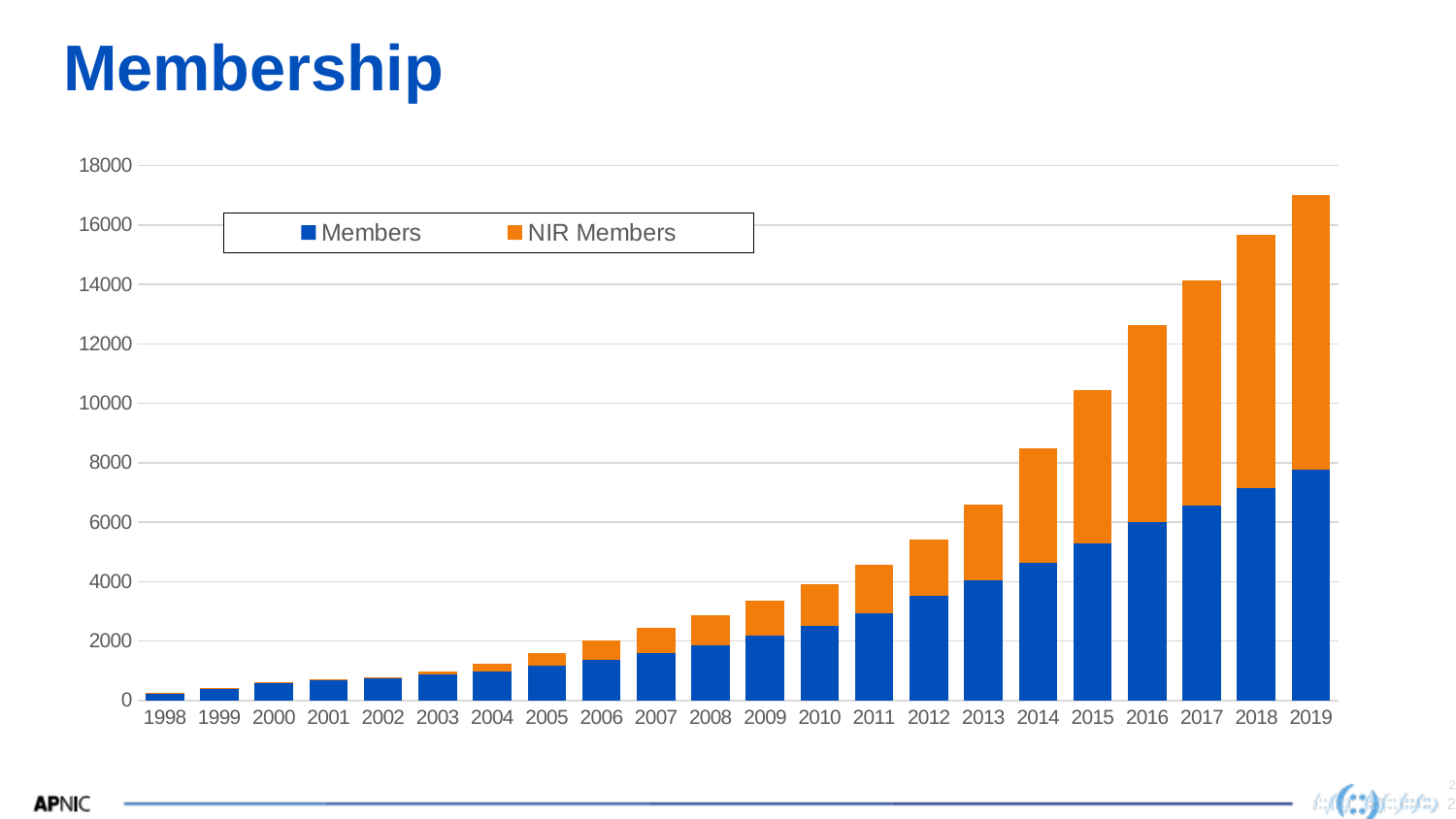
Is the total bar for 2016 greater or less than 12000? greater How many years are shown along the x axis? 22 Do the total membership bars rise or fall from 1998 to 2019? rise What kind of chart is shown on the slide? stacked bar chart Which year has the highest total membership bar? 2019 Is the total bar for 2015 greater or less than 10000? greater Which year has the lowest total membership bar? 1998 How many series does the legend list? 2 What are the two series named in the legend? Members and NIR Members Is the total bar for 2019 greater or less than 16000? greater Which year has the larger total bar, 2017 or 2018? 2018